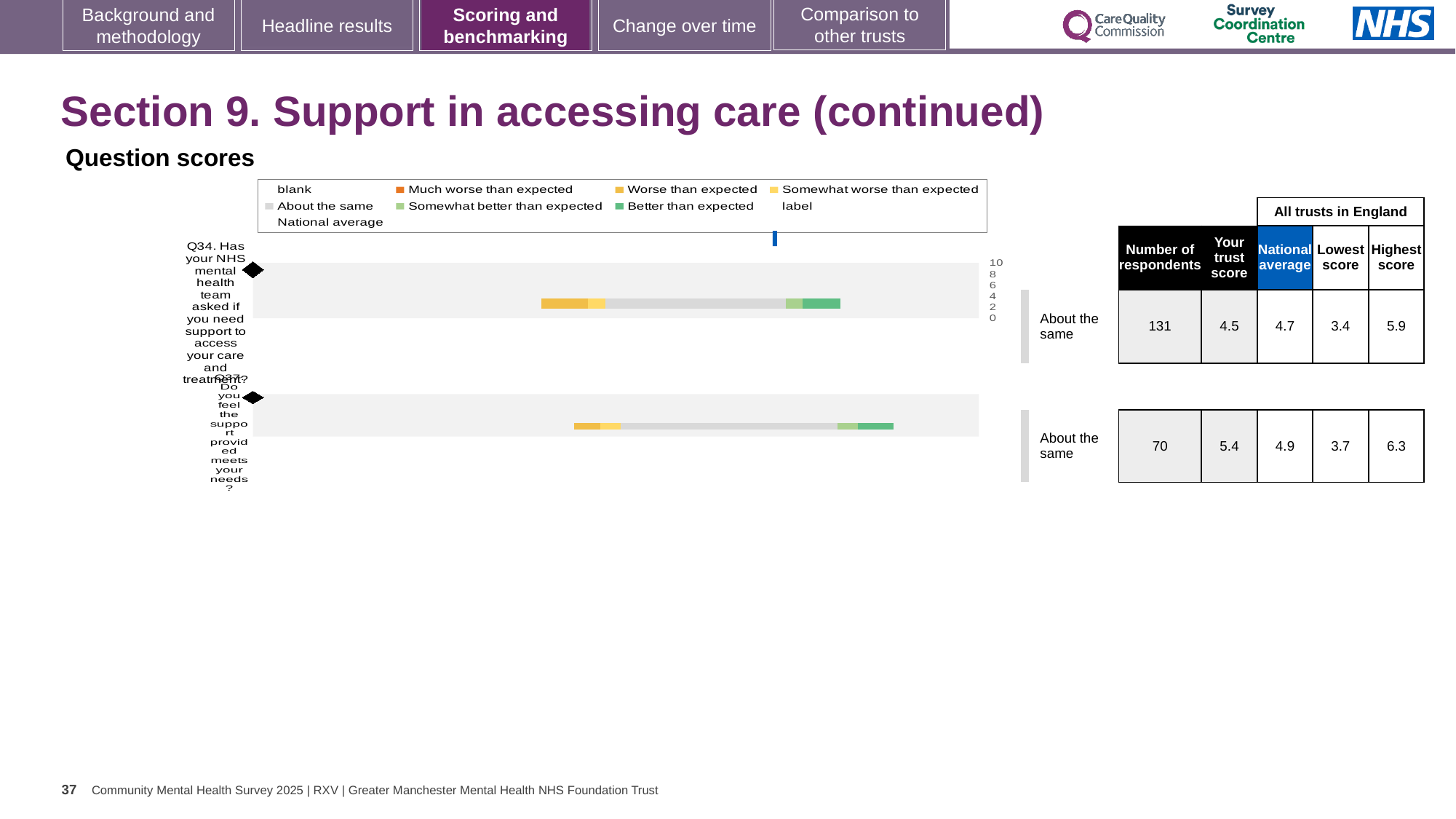
Which question has the higher trust score, Q34 or Q37? Q37 What is the trust score for Q34 (Has your NHS mental health team asked if you need support to access your care and treatment?)? 4.5 What is the trust score for Q37 (Do you feel the support provided meets your needs?)? 5.4 What kind of chart is used to show the question scores on this slide? bar chart Which is larger for Q37, the trust score or the national average? the trust score What benchmark category is shown for Q34? About the same Which is larger for Q34, the trust score or the national average? the national average How many survey questions are plotted in the question scores chart? 2 What is the highest score among all trusts in England for Q37? 6.3 How many respondents answered Q34? 131 What is the national average score for Q34? 4.7 What is the difference between the highest and lowest scores for Q37? 2.6